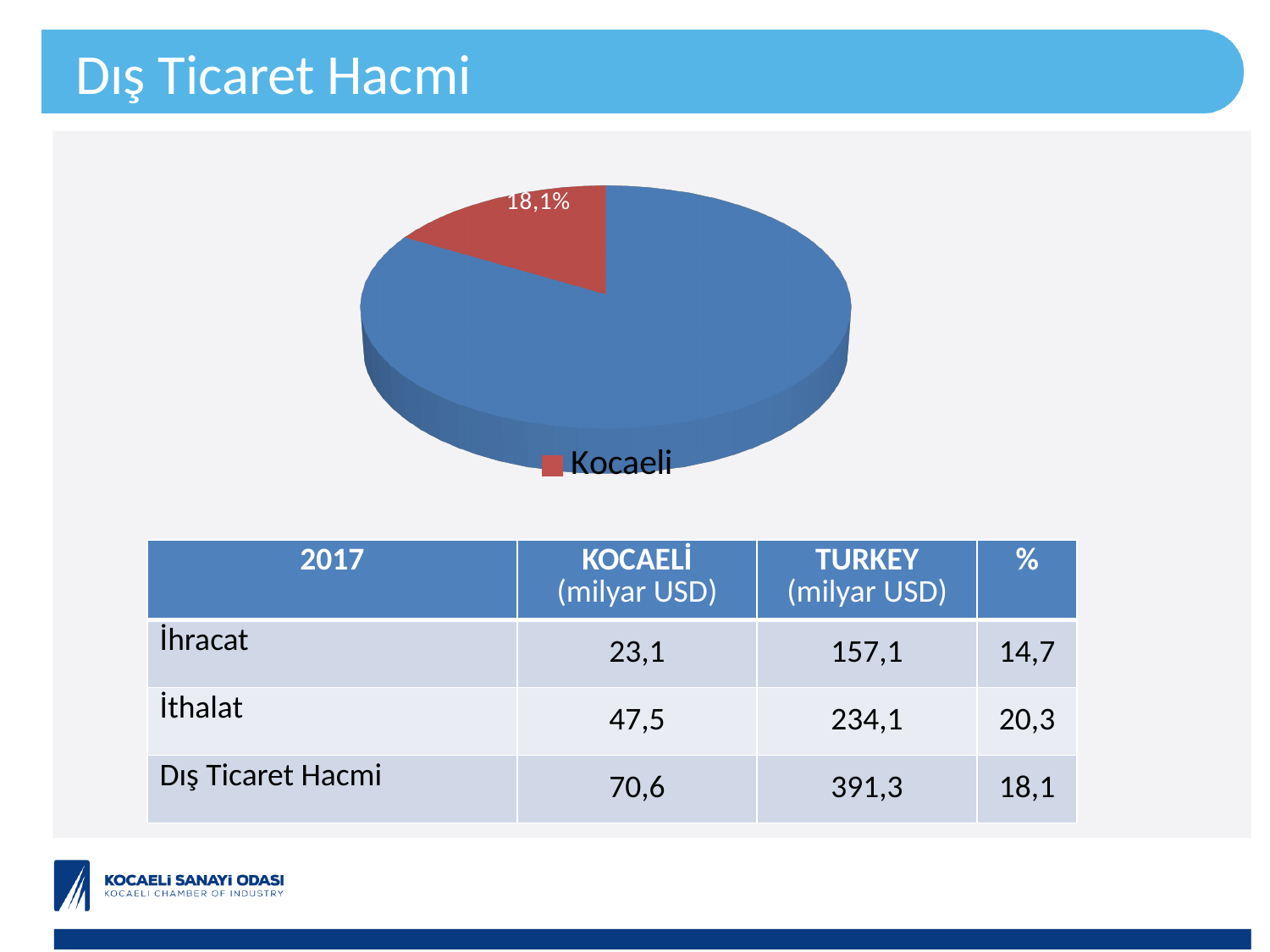
How many entries does the pie chart's legend list? 1 What colour is the Kocaeli slice in the pie chart? Red What is the title of the slide containing the pie chart? Dış Ticaret Hacmi Which slice of the pie is larger, the red Kocaeli slice or the blue slice? The blue slice Which slice of the pie chart is the smallest? Kocaeli How many slices does the pie chart have? 2 What share of the pie does the Kocaeli slice represent? 18,1% What kind of chart is shown on the slide? Pie chart